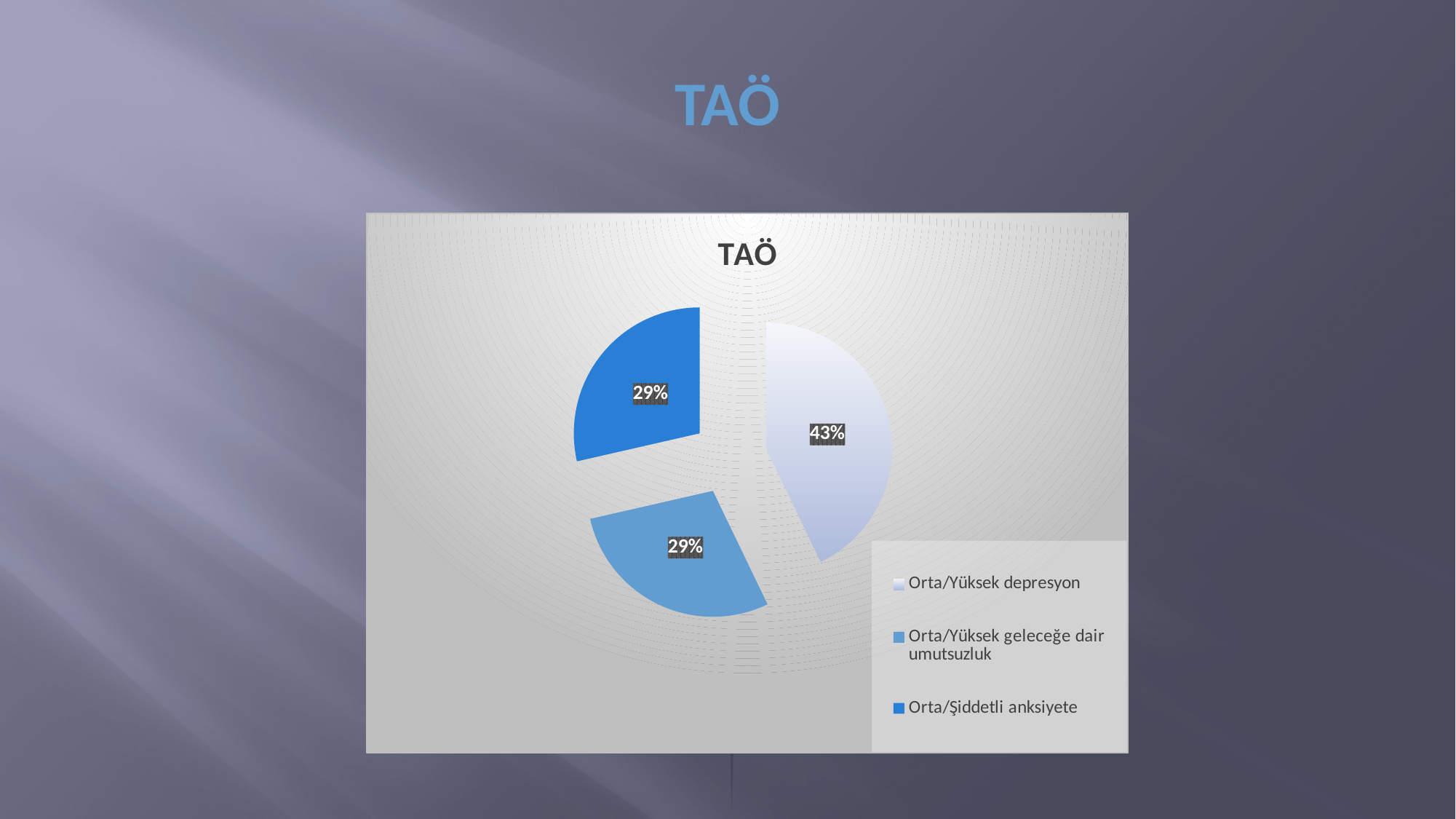
Is the share for Orta/Yüksek depresyon greater or less than 50%? less How many slices does the pie chart have? 3 What percentage is shown for Orta/Yüksek geleceğe dair umutsuzluk? 29% What is the title of the chart? TAÖ What share of the pie does Orta/Yüksek depresyon represent? 43% What kind of chart is shown on the slide? Pie chart Which category is shown in the darkest blue slice? Orta/Şiddetli anksiyete What percentage is shown for Orta/Şiddetli anksiyete? 29% Which is larger, the slice for Orta/Yüksek depresyon or the slice for Orta/Yüksek geleceğe dair umutsuzluk? Orta/Yüksek depresyon Which category has the largest slice of the pie? Orta/Yüksek depresyon By how many percentage points is Orta/Yüksek depresyon larger than Orta/Şiddetli anksiyete? 14 percentage points